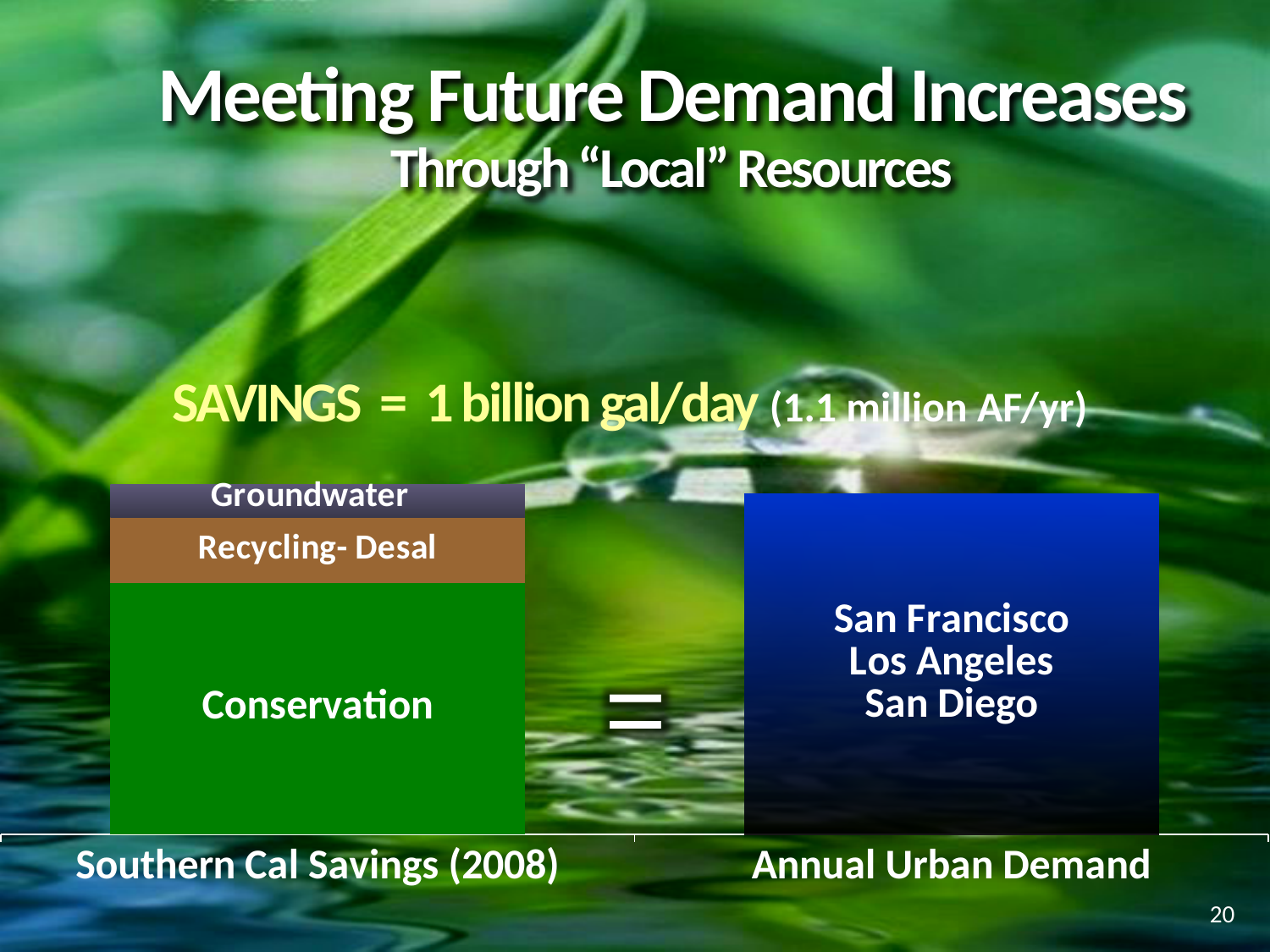
According to the slide, what total savings does the Southern Cal Savings bar represent? 1 billion gal/day (1.1 million AF/yr) What is the label under the right bar? Annual Urban Demand Which segment of the Southern Cal Savings (2008) bar is the smallest? Groundwater What kind of chart is shown on the slide? bar chart What is the label under the left bar? Southern Cal Savings (2008) How many segments make up the Southern Cal Savings (2008) bar? 3 Which is larger in the Southern Cal Savings (2008) bar, the Recycling- Desal segment or the Groundwater segment? Recycling- Desal Which is larger in the Southern Cal Savings (2008) bar, the Conservation segment or the Recycling- Desal segment? Conservation Which three cities are named in the Annual Urban Demand bar? San Francisco, Los Angeles, San Diego Which segment of the Southern Cal Savings (2008) bar is the largest? Conservation How many bars are shown on the slide? 2 Which segment sits at the top of the Southern Cal Savings (2008) bar? Groundwater